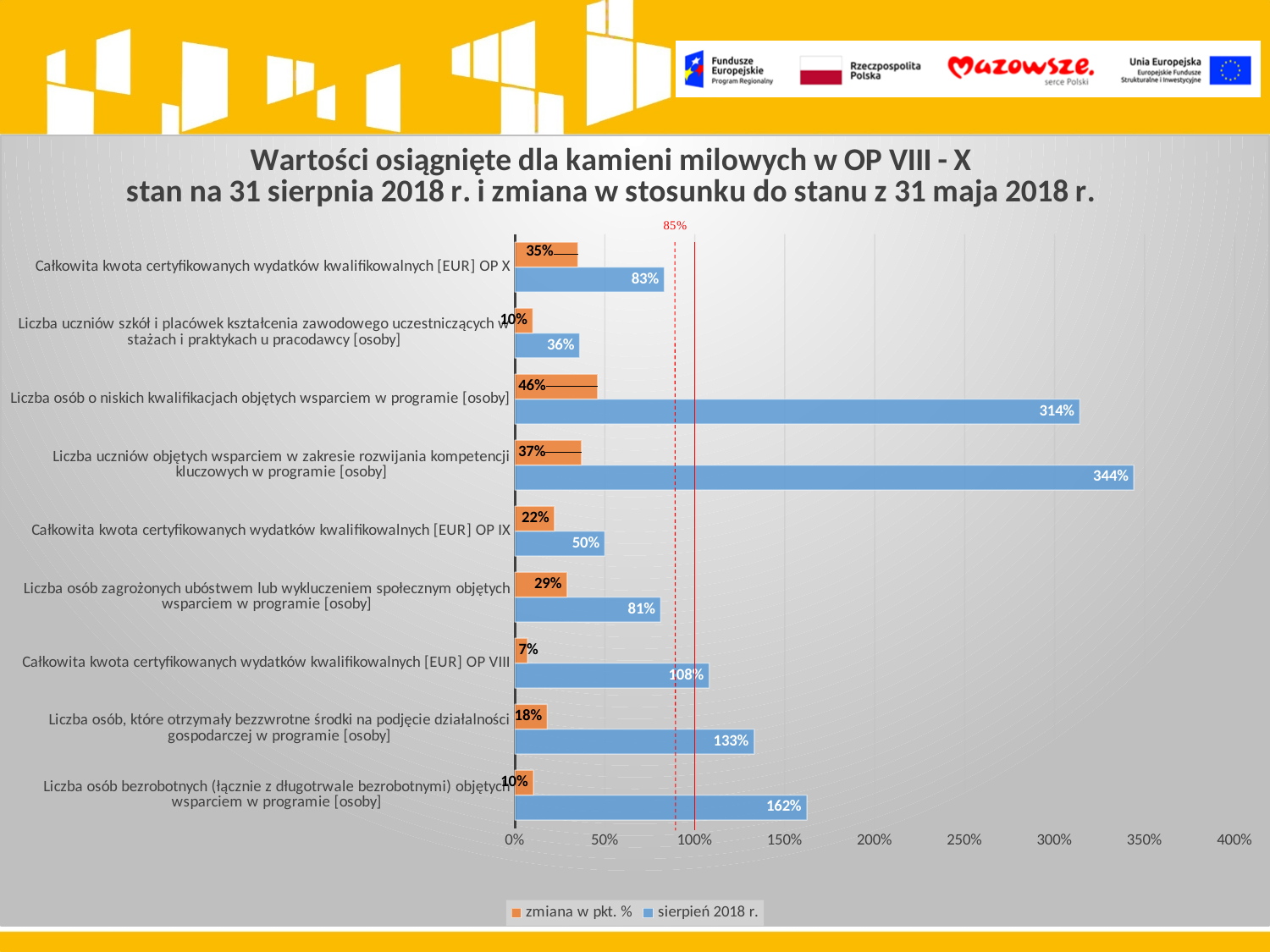
What is the difference between the 'sierpień 2018 r.' values for 'Liczba osób bezrobotnych (łącznie z długotrwale bezrobotnymi) objętych wsparciem w programie [osoby]' and 'Liczba osób, które otrzymały bezzwrotne środki na podjęcie działalności gospodarczej w programie [osoby]'? 29% What is the 'zmiana w pkt. %' value for 'Całkowita kwota certyfikowanych wydatków kwalifikowalnych [EUR] OP X'? 35% How many series does the legend list? 2 What kind of chart is shown on the slide? bar chart What is the 'sierpień 2018 r.' value for 'Całkowita kwota certyfikowanych wydatków kwalifikowalnych [EUR] OP VIII'? 108% Which is larger: the 'sierpień 2018 r.' value for 'Całkowita kwota certyfikowanych wydatków kwalifikowalnych [EUR] OP IX' or for 'Całkowita kwota certyfikowanych wydatków kwalifikowalnych [EUR] OP X'? Całkowita kwota certyfikowanych wydatków kwalifikowalnych [EUR] OP X Which category has the highest 'sierpień 2018 r.' value? Liczba uczniów objętych wsparciem w zakresie rozwijania kompetencji kluczowych w programie [osoby] How many categories are shown on the chart? 9 What is the 'sierpień 2018 r.' value for 'Liczba osób o niskich kwalifikacjach objętych wsparciem w programie [osoby]'? 314% Which series is shown in orange in the legend? zmiana w pkt. % Which category has the lowest 'zmiana w pkt. %' value? Całkowita kwota certyfikowanych wydatków kwalifikowalnych [EUR] OP VIII Is the 'sierpień 2018 r.' value for 'Liczba osób zagrożonych ubóstwem lub wykluczeniem społecznym objętych wsparciem w programie [osoby]' greater or less than 100%? less